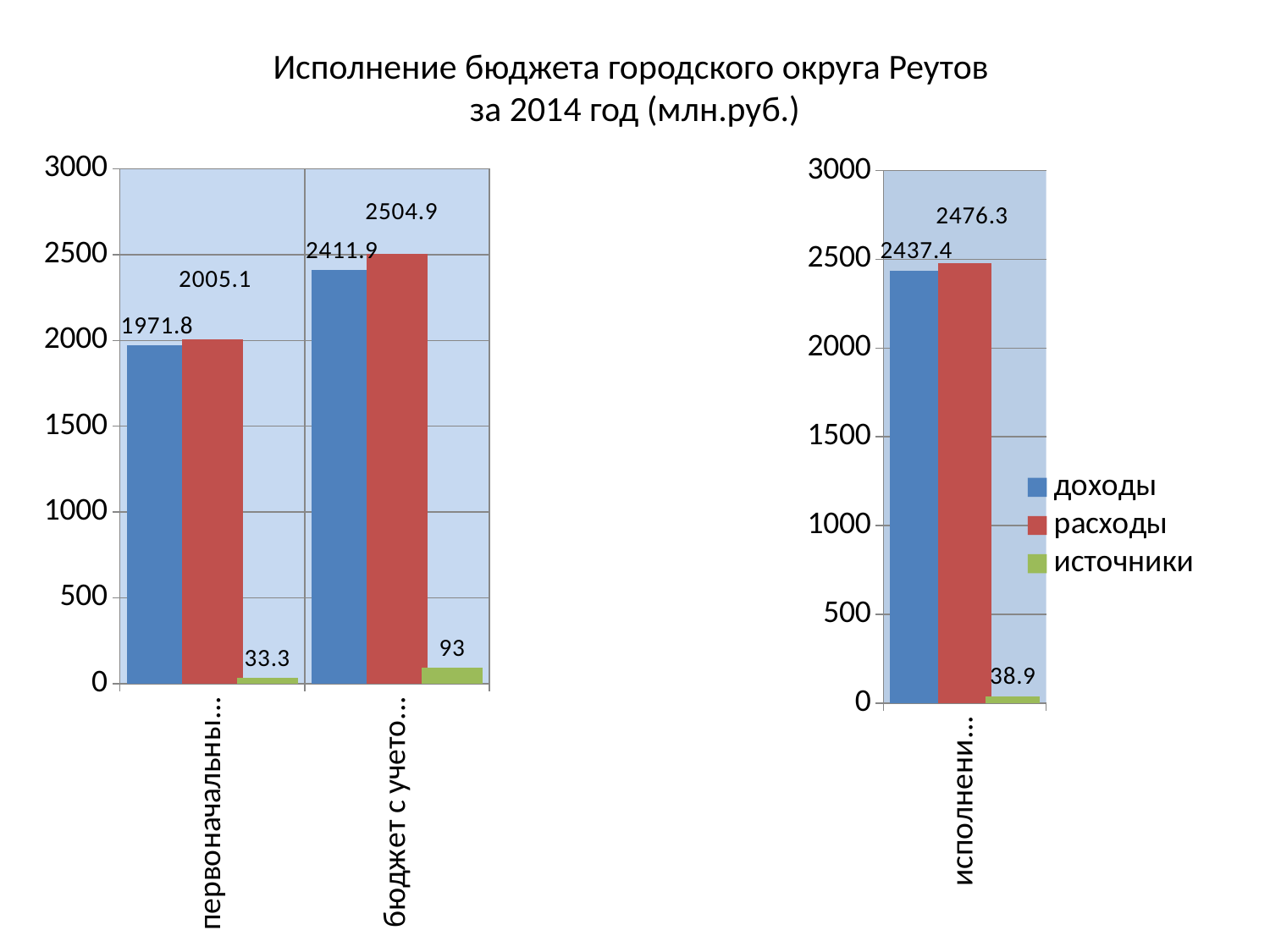
How many series does the legend list? 3 In the left chart, what is the difference between расходы and доходы for the second (right) category? 93 In the left chart, which series has the highest value in the first (left) category? расходы In the left chart, what is the value of источники for the second (right) category? 93 In the right chart, what is the value of доходы? 2437.4 In the left chart, what is the value of расходы for the first (left) category? 2005.1 In the left chart, does the value of доходы rise or fall from the first category to the second? rise What kind of chart is shown on the slide? bar chart In the right chart, which is larger, доходы or расходы? расходы In the left chart, what is the value of доходы for the second (right) category? 2411.9 In the right chart, what is the difference between расходы and доходы? 38.9 In the right chart, is the value for источники greater or less than 500? less